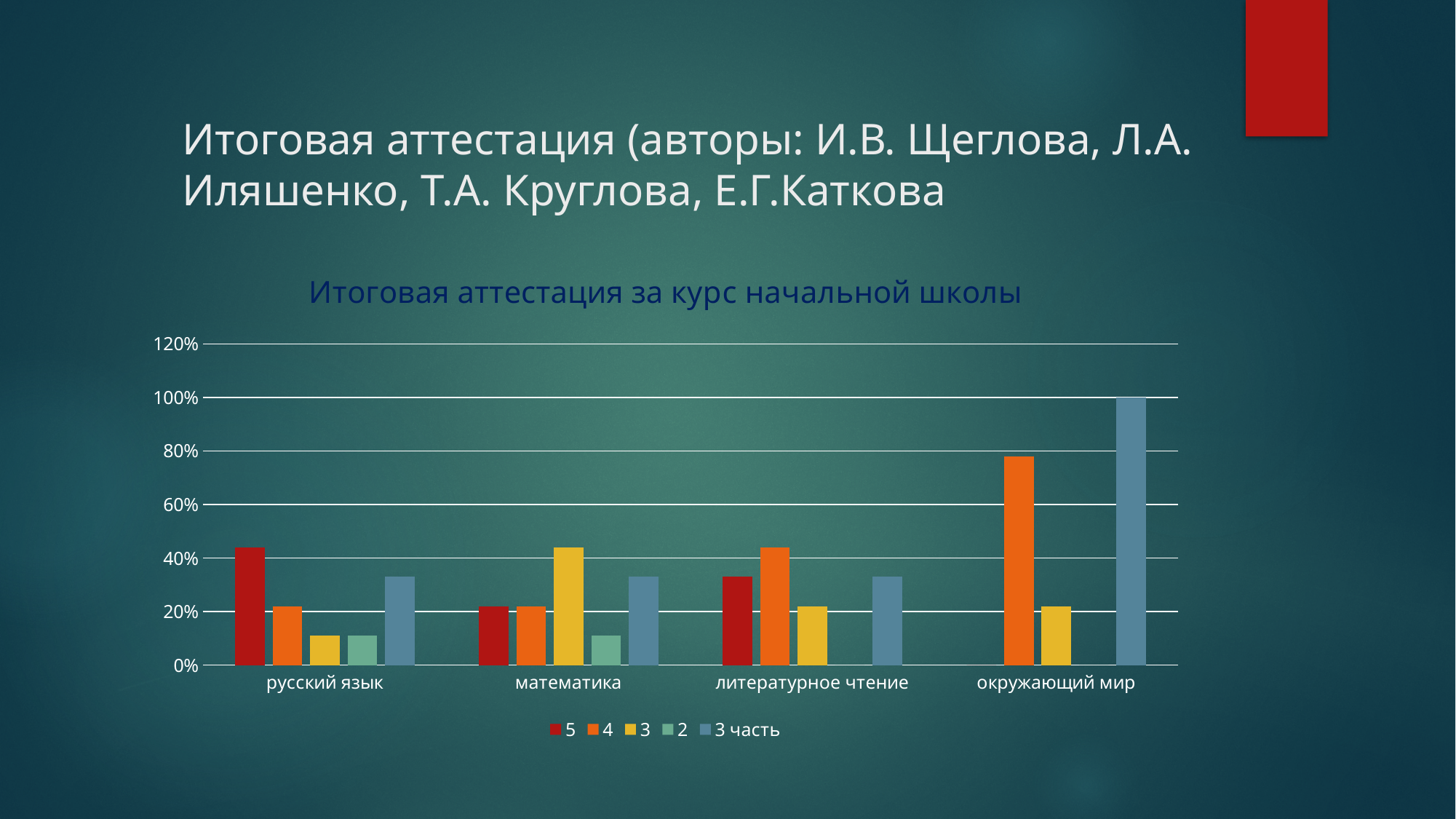
How many subject categories are shown on the x axis? 4 Which legend entry is shown in dark red? 5 Is the value of series "2" for математика greater or less than 20%? less What is the value of the "3 часть" bar for окружающий мир? 100% Which category has the tallest bar in the chart? окружающий мир Is the value of series "5" for русский язык greater or less than 60%? less What is the title of the chart? Итоговая аттестация за курс начальной школы Is the value of series "4" for окружающий мир greater or less than 60%? greater What kind of chart is shown on the slide? bar chart Which is larger for литературное чтение: series "5" or series "4"? 4 Which is larger for математика: series "3" or series "4"? 3 How many series does the legend list? 5